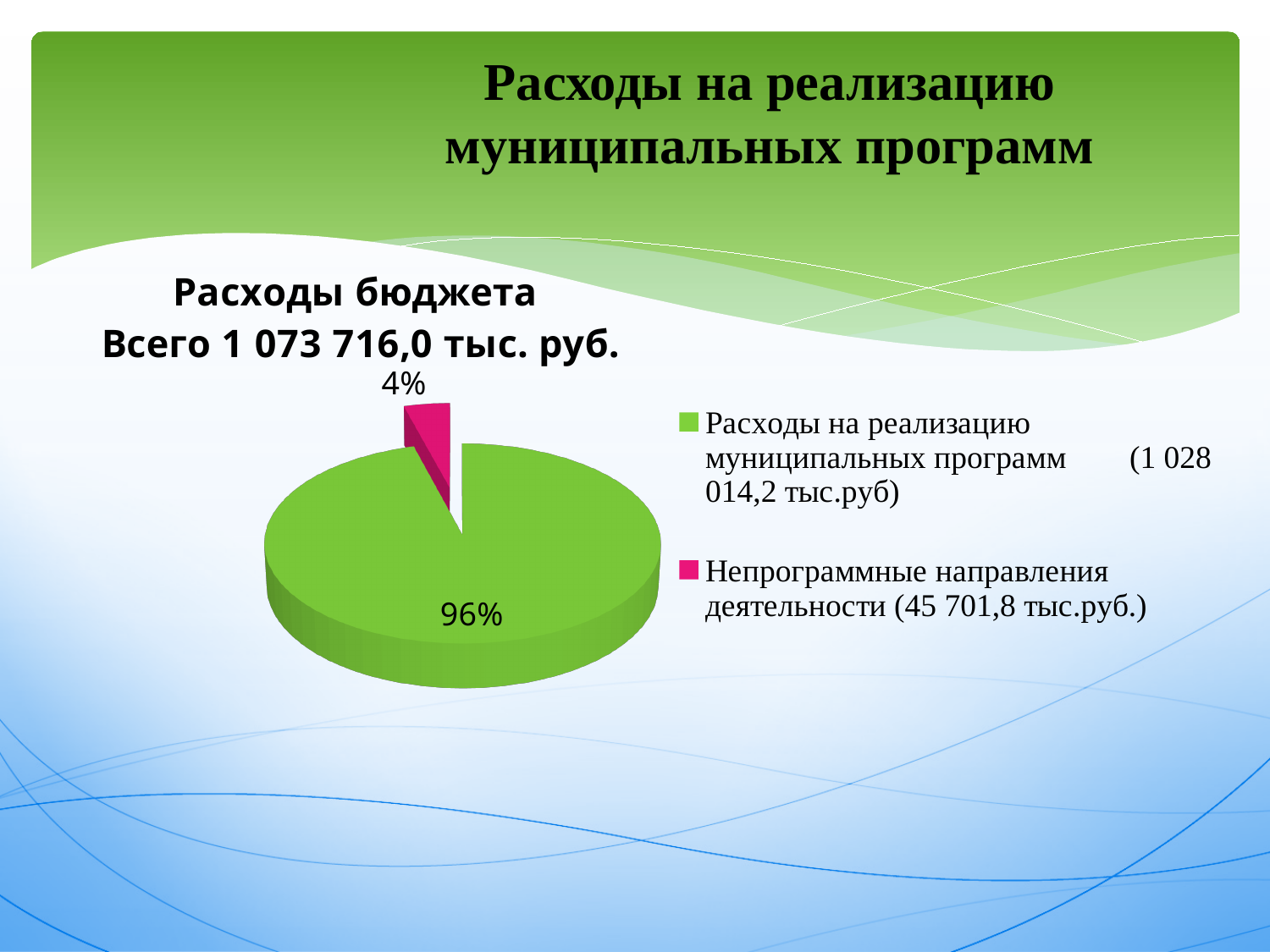
How many entries does the legend list? 2 What total is stated in the chart title? 1 073 716,0 тыс. руб. How many slices does the pie chart have? 2 What share of the pie does "Непрограммные направления деятельности" take? 4% What kind of chart is shown on the slide? pie chart What is the difference in percentage points between the 96% slice and the 4% slice? 92 percentage points Which is larger: the share for "Расходы на реализацию муниципальных программ" or the share for "Непрограммные направления деятельности"? Расходы на реализацию муниципальных программ What amount in тыс.руб. is given in the legend for "Расходы на реализацию муниципальных программ"? 1 028 014,2 тыс.руб Which slice of the pie is the smallest? Непрограммные направления деятельности What amount in тыс.руб. is given in the legend for "Непрограммные направления деятельности"? 45 701,8 тыс.руб. Which slice of the pie is the largest? Расходы на реализацию муниципальных программ What share of the pie does "Расходы на реализацию муниципальных программ" take? 96%